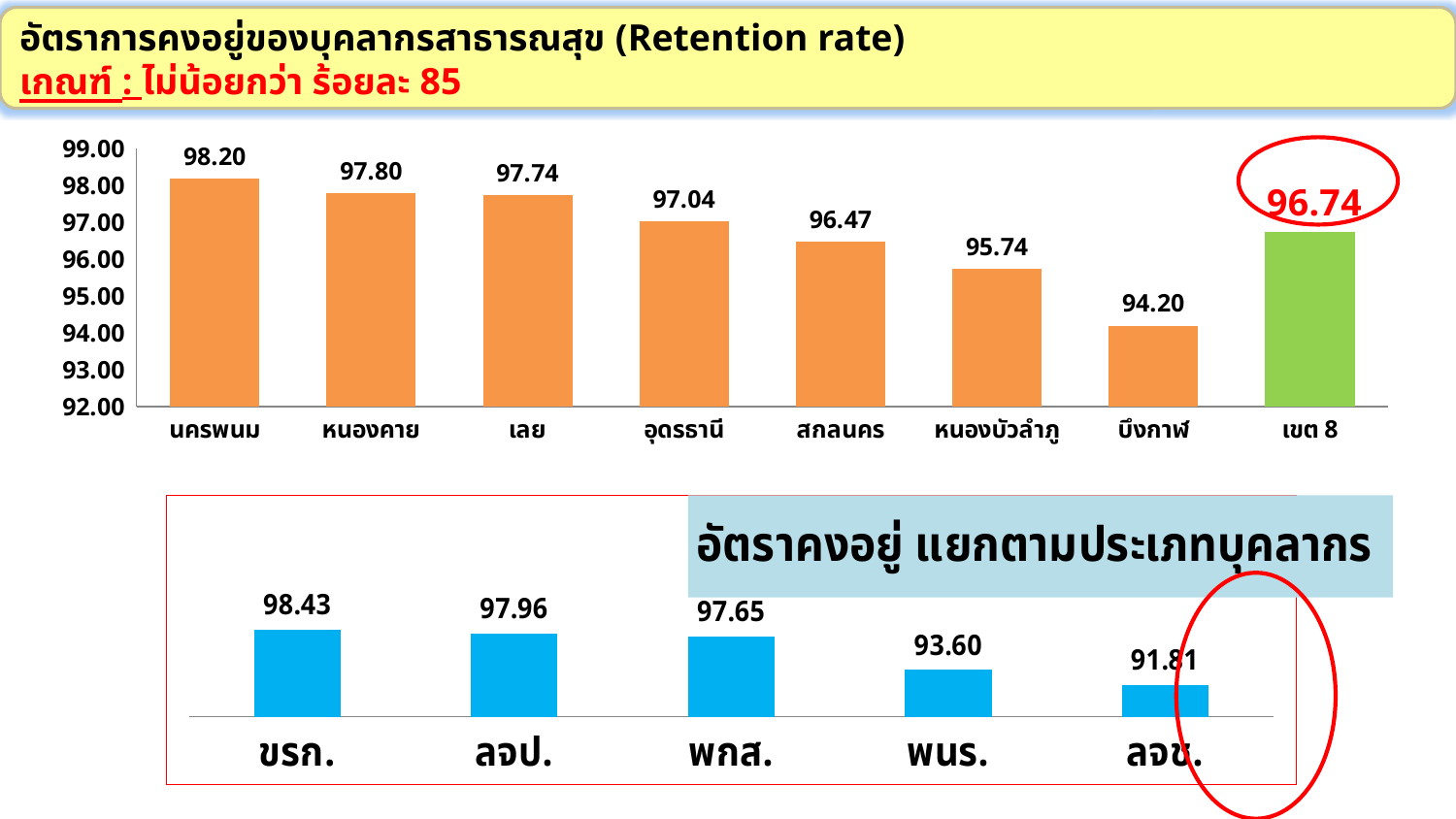
In the top chart, which is larger, the value for สกลนคร or the value for หนองบัวลำภู? สกลนคร In the top chart, what is the retention rate for นครพนม? 98.20 In the bottom chart, what is the difference between the values for ขรก. and ลจช.? 6.62 In the bottom chart, which personnel type has the lowest retention rate? ลจช. In the top chart, which province has the lowest retention rate? บึงกาฬ In the bottom chart, do the values rise or fall from left to right? fall In the bottom chart, what is the value for พนร.? 93.60 In the top chart, what is the difference between the values for นครพนม and บึงกาฬ? 4.00 In the top chart, what is the value shown for เขต 8? 96.74 In the top chart, which category has the highest value? นครพนม What type of chart is the top chart? bar chart How many bars are plotted in the top chart? 8